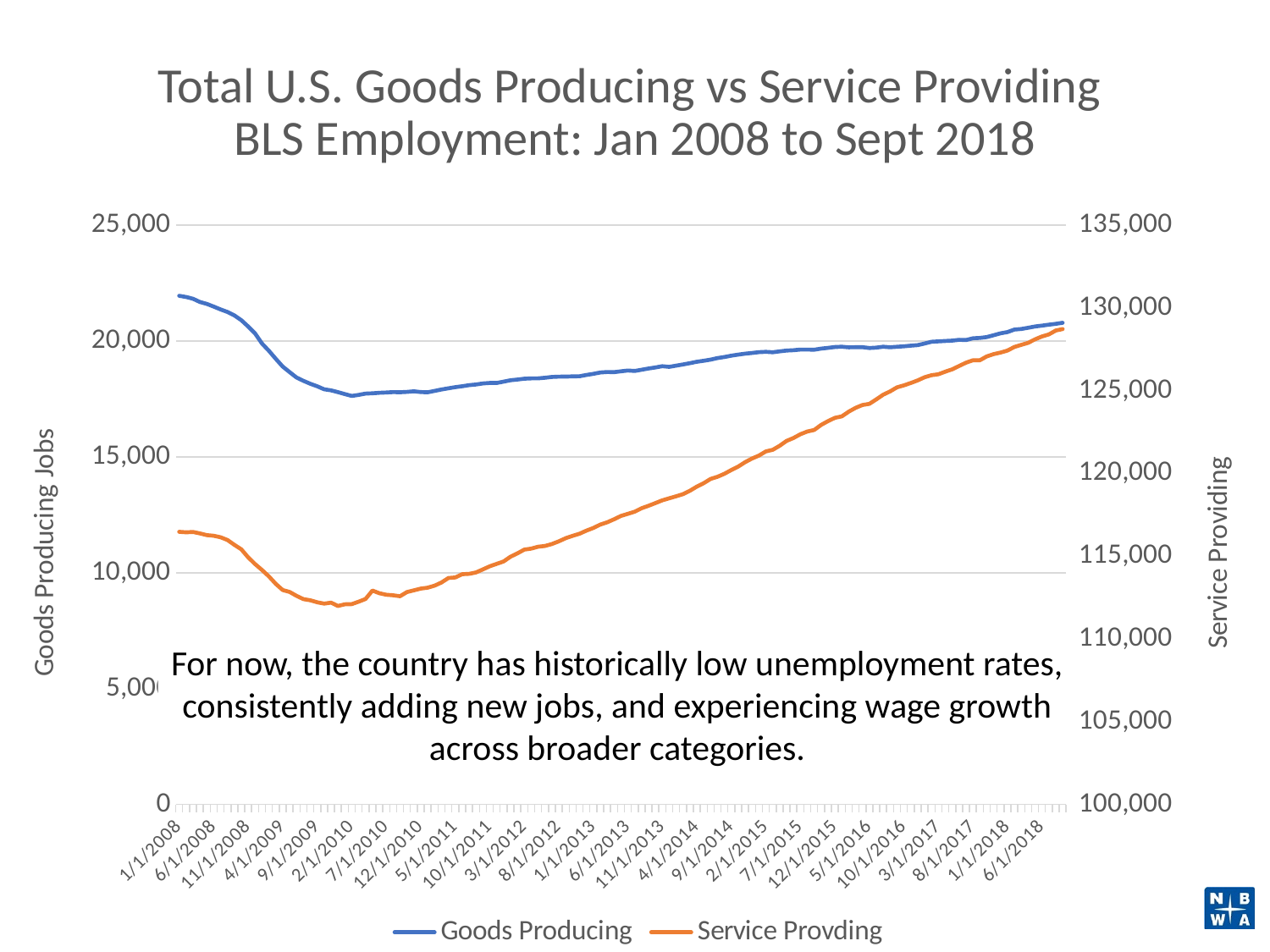
Is the Service Providing value at 6/1/2018 greater or less than 125,000 on the right axis? greater What is the title of the left vertical axis? Goods Producing Jobs Does the Goods Producing line rise or fall between 1/1/2008 and 9/1/2009? fall What kind of chart is shown on the slide? line chart What is the title of the chart? Total U.S. Goods Producing vs Service Providing BLS Employment: Jan 2008 to Sept 2018 Is the Service Providing value at 2/1/2010 greater or less than 115,000 on the right axis? less Which series is drawn in orange? Service Provding Does the Service Providing line rise or fall between 2/1/2010 and 6/1/2018? rise Is the Goods Producing value at 1/1/2008 greater or less than 20,000 on the left axis? greater How many series does the legend list? 2 In which year does the Goods Producing line reach its lowest point? 2010